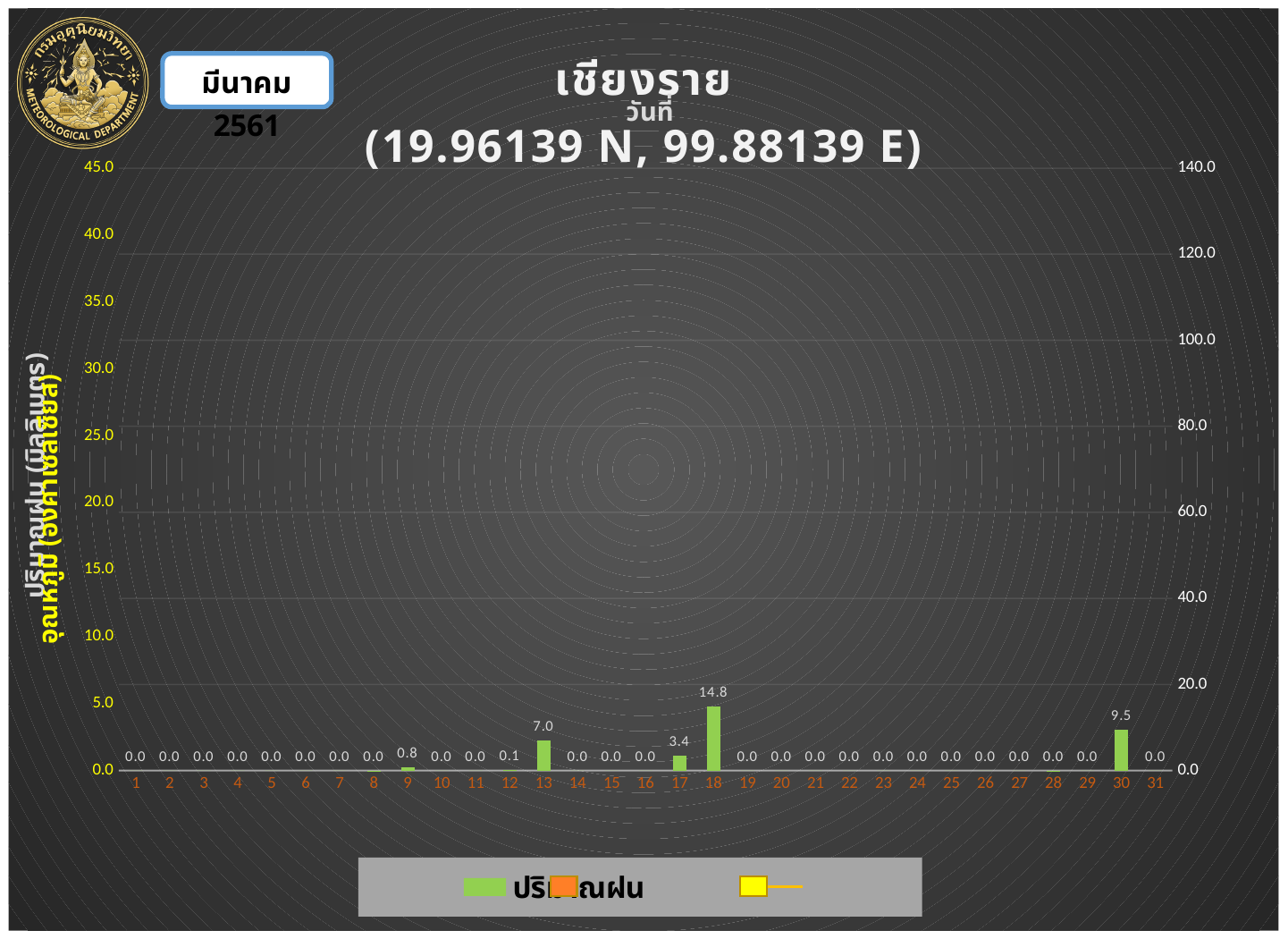
What is the rainfall value labelled for day 12? 0.1 What kind of chart is shown on the slide? Bar chart What is the rainfall value labelled for day 18? 14.8 What coordinates are given in the chart title? 19.96139 N, 99.88139 E What is the difference between the rainfall values for day 18 and day 30? 5.3 What is the rainfall value labelled for day 30? 9.5 What is the rainfall value labelled for day 13? 7.0 What is the rainfall value labelled for day 9? 0.8 Which has the larger rainfall value, day 13 or day 30? Day 30 Which day has the highest rainfall value? 18 How many days are shown on the x axis? 31 What is the rainfall value labelled for day 17? 3.4